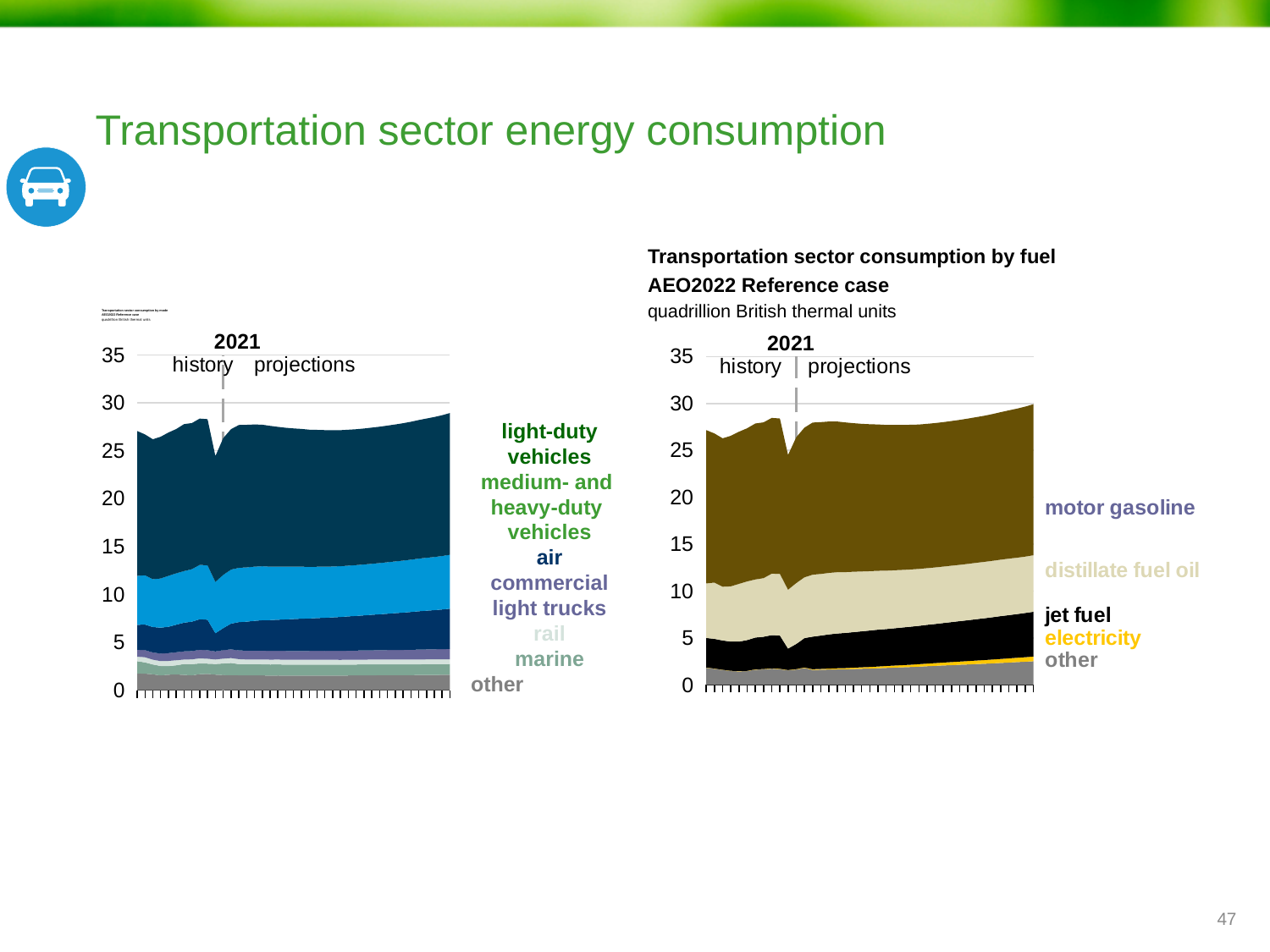
In the right-hand chart, 'Transportation sector consumption by fuel', which fuel has the smallest share of consumption? electricity In the right-hand chart, is the total transportation consumption at the end of the projection period greater or less than 20 quadrillion British thermal units? greater In the left-hand chart, which mode accounts for the largest share of transportation energy consumption? light-duty vehicles In the right-hand chart, which is larger, consumption of motor gasoline or consumption of jet fuel? motor gasoline In the right-hand chart, does total transportation consumption rise or fall over the projection period? rise Which year separates history from projections in the charts? 2021 In the right-hand chart, 'Transportation sector consumption by fuel', which fuel accounts for the largest share of consumption? motor gasoline What kind of chart is the 'Transportation sector consumption by fuel' chart on the right? stacked area chart How many fuel categories are labelled on the right-hand chart, 'Transportation sector consumption by fuel'? 5 In the right-hand chart, is the total transportation consumption at the start of the history period greater or less than 25 quadrillion British thermal units? greater What unit is used on the y-axis of the 'Transportation sector consumption by fuel' chart? quadrillion British thermal units How many mode categories are labelled on the left-hand chart? 7